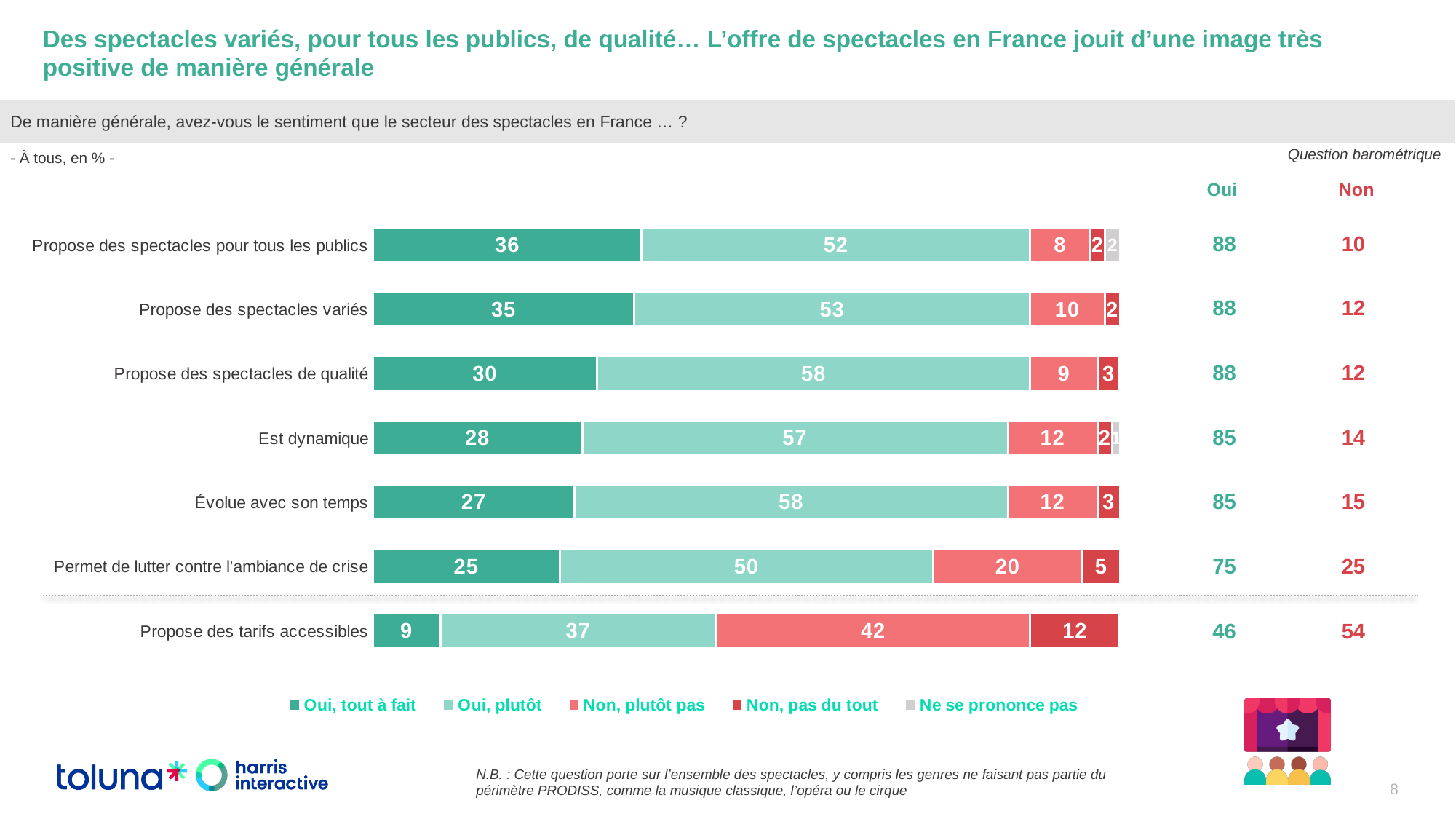
What is the difference between the "Non, plutôt pas" values for "Permet de lutter contre l'ambiance de crise" and "Est dynamique"? 8 What kind of chart is shown on the slide? Stacked bar chart What is the combined "Oui" total shown for "Propose des tarifs accessibles"? 46 What is the value of "Non, pas du tout" for "Permet de lutter contre l'ambiance de crise"? 5 How many series does the legend list? 5 Which category has the lowest "Oui, tout à fait" value? Propose des tarifs accessibles Which is larger: the "Oui, plutôt" value for "Propose des spectacles variés" or for "Propose des spectacles pour tous les publics"? Propose des spectacles variés What is the value of "Non, plutôt pas" for "Propose des tarifs accessibles"? 42 Which category has the highest "Oui, tout à fait" value? Propose des spectacles pour tous les publics What is the value of "Oui, tout à fait" for "Propose des spectacles pour tous les publics"? 36 What is the value of "Oui, plutôt" for "Propose des spectacles de qualité"? 58 How many categories are shown in the chart? 7